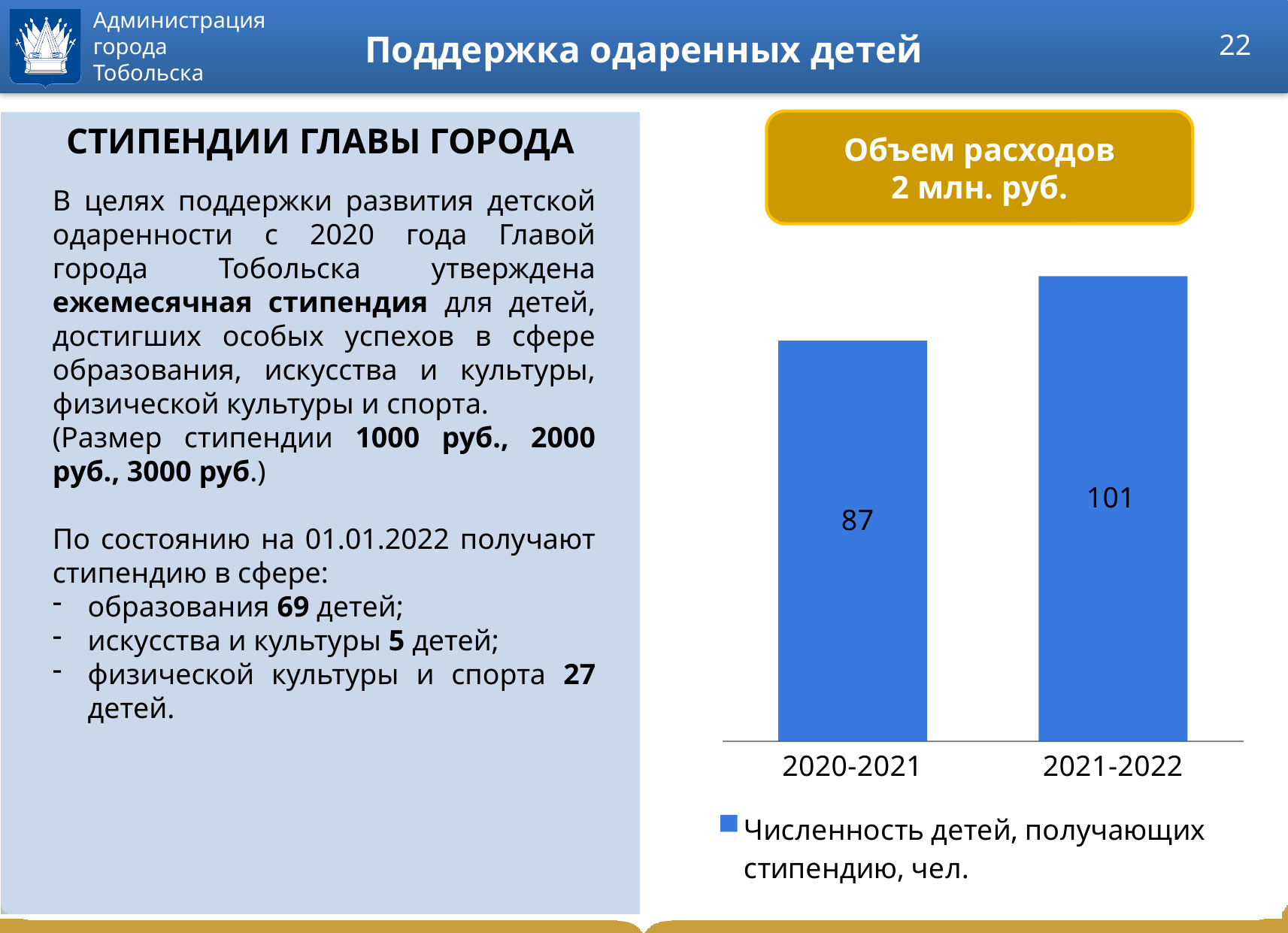
Which is larger: the value for 2020-2021 or for 2021-2022? 2021-2022 What is the value for 2021-2022 in the chart? 101 Do the values rise or fall from 2020-2021 to 2021-2022? rise Which period has the lowest value in the chart? 2020-2021 How many series does the chart legend list? 1 What kind of chart is shown on the slide? bar chart What colour are the bars in the chart? blue How many categories are shown on the x axis of the chart? 2 Which period has the highest value in the chart? 2021-2022 What is the value for 2020-2021 in the chart? 87 What is the legend entry of the chart? Численность детей, получающих стипендию, чел. What is the difference between the values for 2021-2022 and 2020-2021? 14